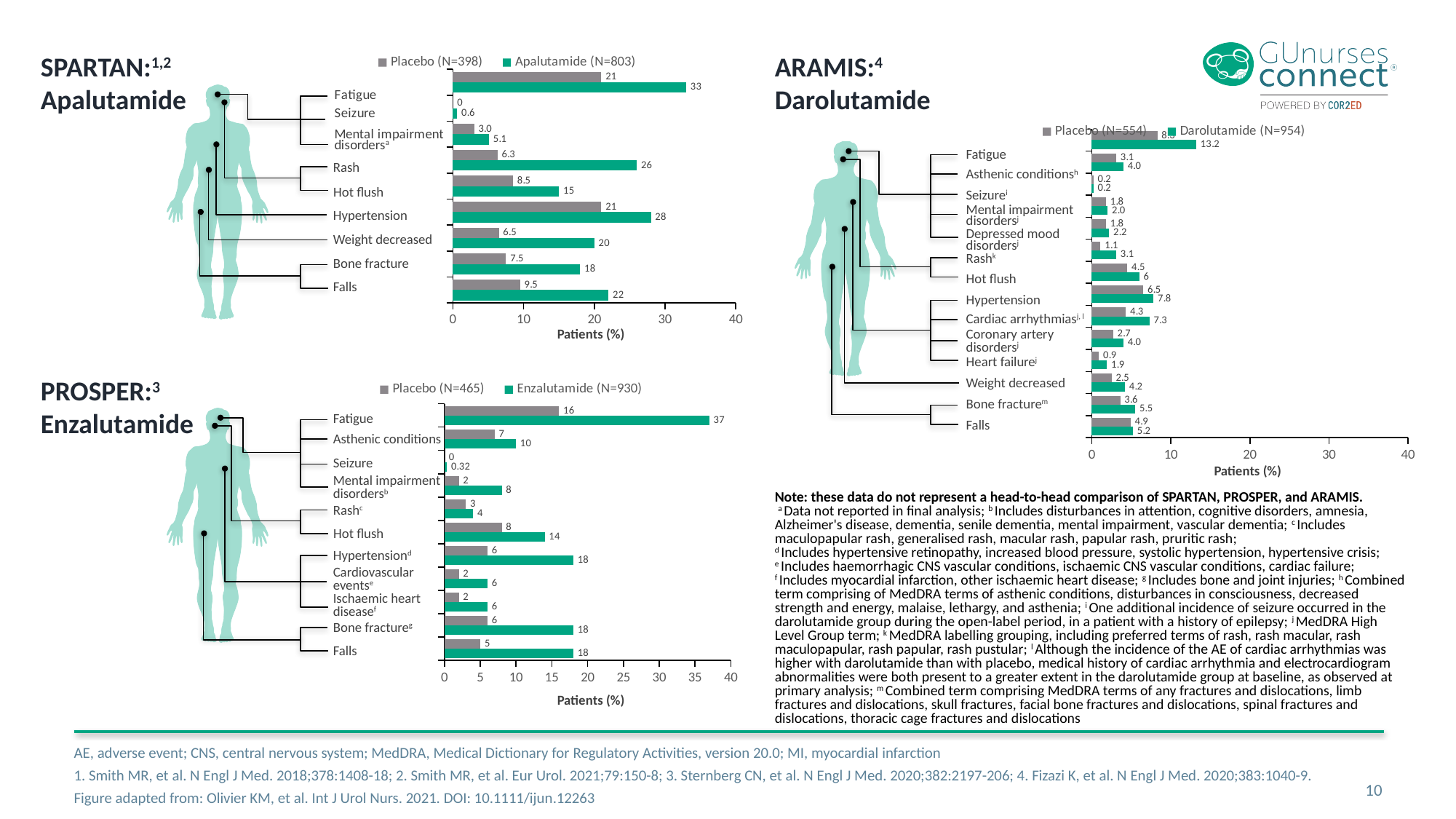
In the SPARTAN: Apalutamide chart, what is the difference between the Apalutamide and Placebo values for weight decreased? 13.5 In the SPARTAN: Apalutamide chart, what is the value for rash in the Placebo group? 6.3 In the PROSPER: Enzalutamide chart, what is the difference between the Enzalutamide and Placebo values for fatigue? 21 In the SPARTAN: Apalutamide chart, what percentage of patients in the Apalutamide group had fatigue? 33 What type of chart is used for the SPARTAN: Apalutamide data? Bar chart In the SPARTAN: Apalutamide chart, which adverse event has the highest value for the Apalutamide group? Fatigue In the ARAMIS: Darolutamide chart, how many series does the legend list? 2 In the PROSPER: Enzalutamide chart, how many adverse event categories are shown? 11 In the PROSPER: Enzalutamide chart, which is larger for hot flush: the Placebo value or the Enzalutamide value? Enzalutamide In the ARAMIS: Darolutamide chart, what is the value for cardiac arrhythmias in the Darolutamide group? 7.3 In the PROSPER: Enzalutamide chart, what is the value for seizure in the Enzalutamide group? 0.32 In the ARAMIS: Darolutamide chart, what is the Placebo value for hypertension? 6.5